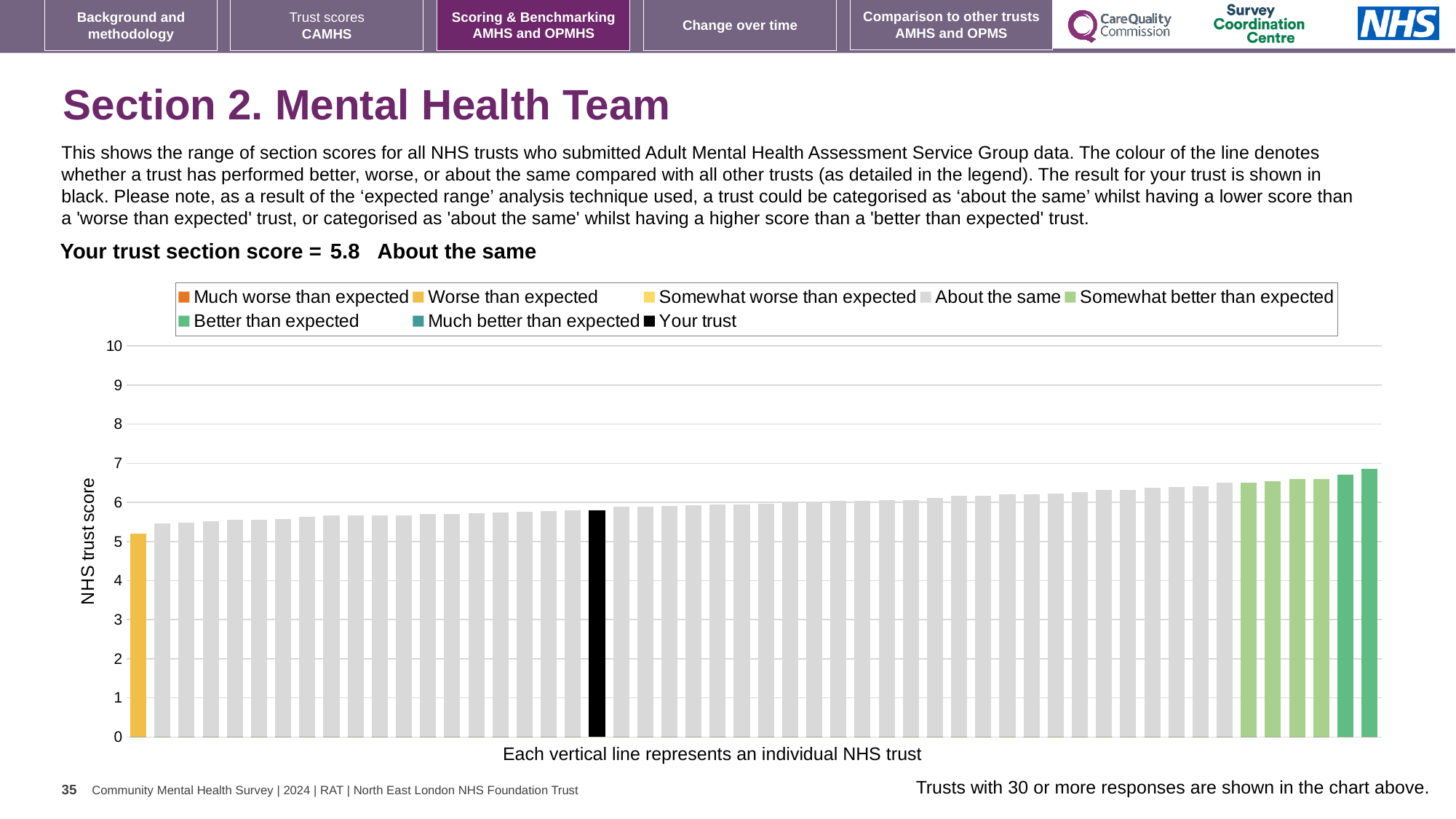
What colour is the bar representing your trust? Black What is the label on the vertical axis of the chart? NHS trust score Is the value of the rightmost (highest) bar greater or less than 6? greater What kind of chart is shown on the slide? Bar chart What is the section score for your trust shown on the slide? 5.8 Is the value for your trust greater or less than 7? less Which category is your trust's section score placed in? About the same Is the value for your trust greater or less than 5? greater How many entries does the chart legend list? 8 Which is higher: the leftmost bar or the bar for your trust? Your trust Do the bar values rise or fall from left to right across the chart? Rise